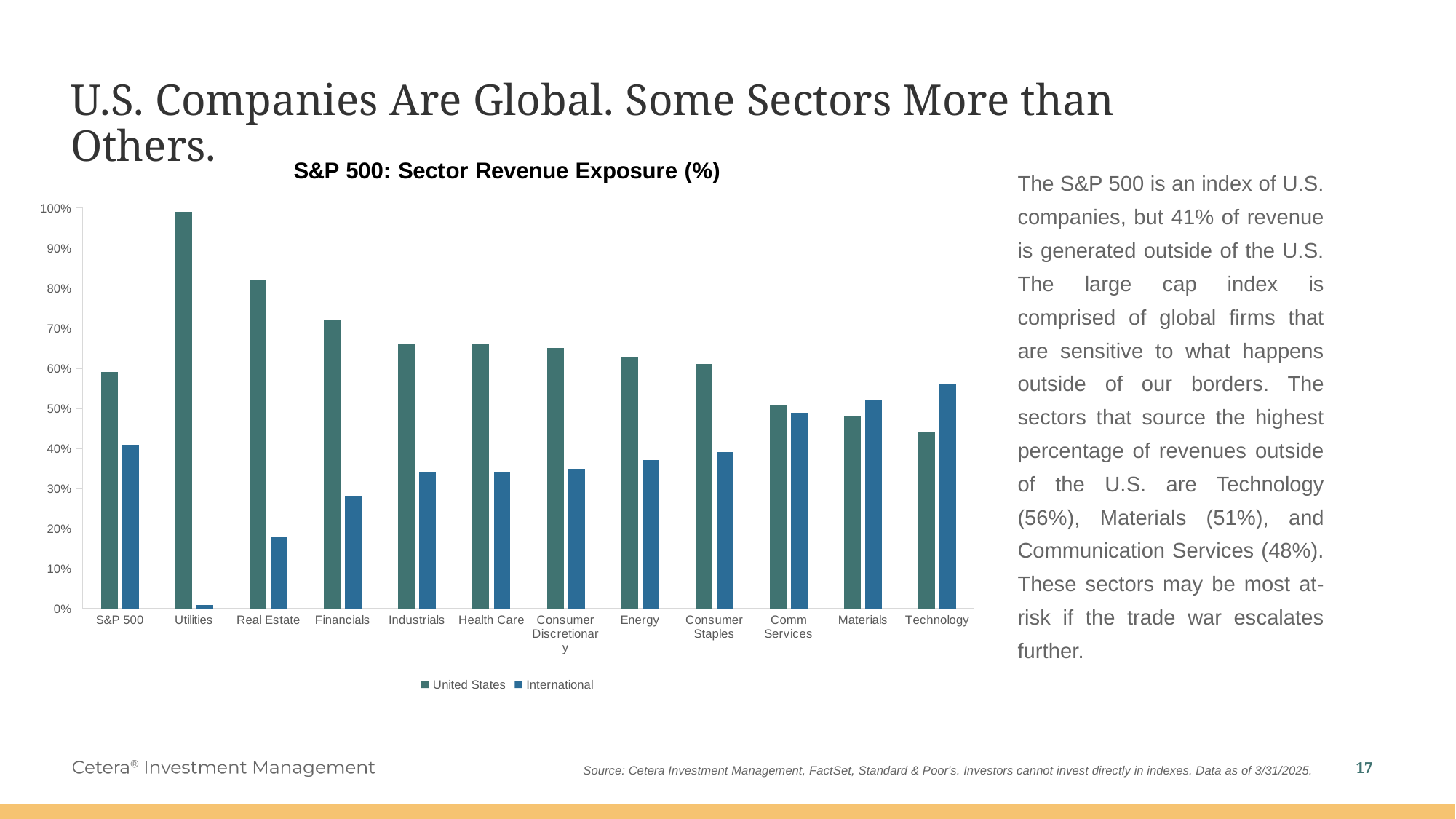
For Financials, which is larger: the United States value or the International value? United States Is the International value for Real Estate greater or less than 20%? less Which category has the lowest International value? Utilities Is the International value for Technology greater or less than 50%? greater Which category has the lowest United States value? Technology What is the title of the chart? S&P 500: Sector Revenue Exposure (%) How many categories are shown on the x axis? 12 Is the United States value for Utilities greater or less than 90%? greater Which category has the highest United States value? Utilities What kind of chart is shown on the slide? Bar chart How many series does the legend list? 2 Which category has the highest International value? Technology